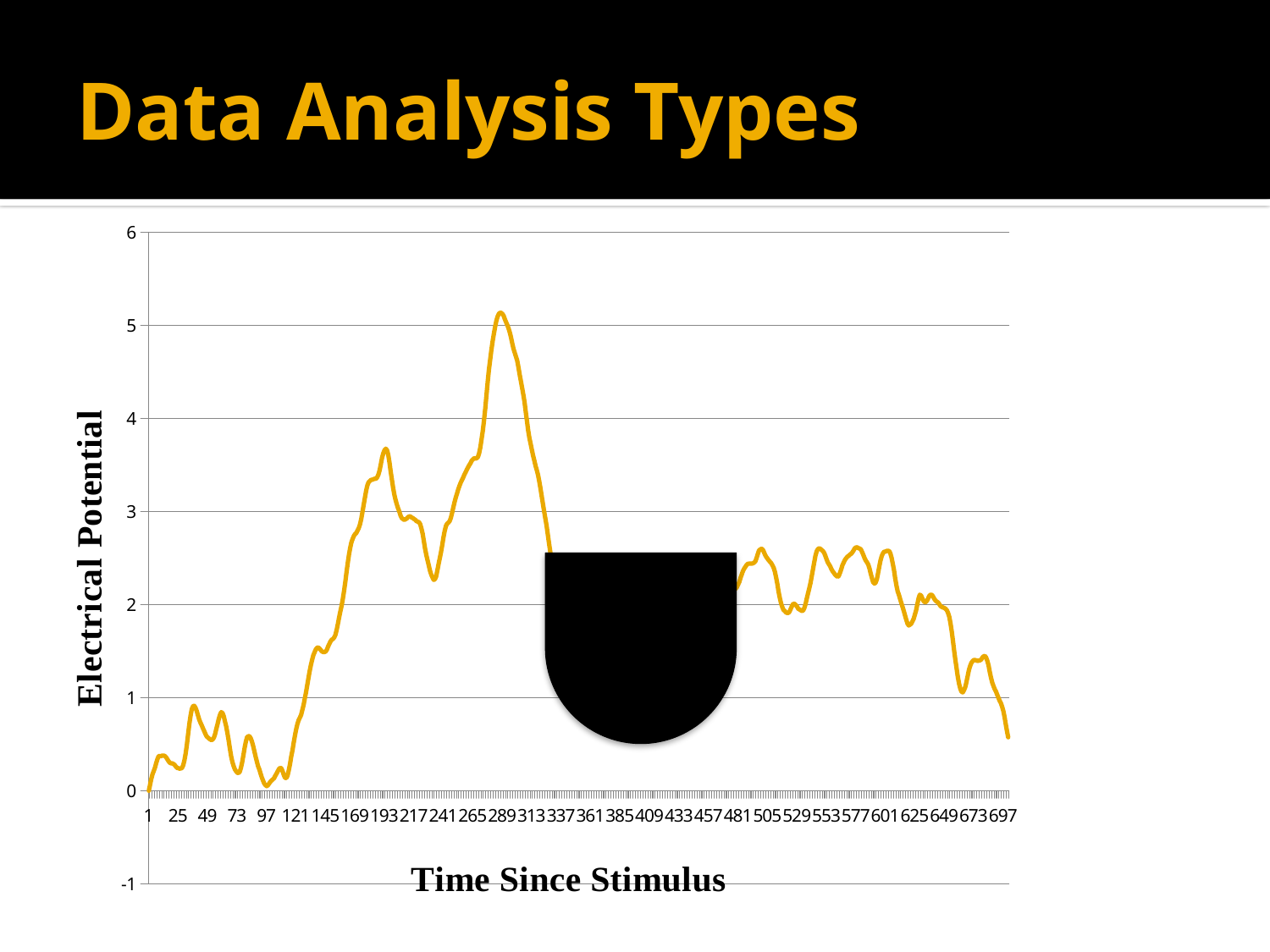
Is the value of the line at time 193 greater or less than 3? greater How many lines (data series) are plotted on the chart? 1 Is the value of the line at time 1 greater or less than 1? less What is the highest value shown on the vertical axis of the chart? 6 Is the value of the line at time 121 greater or less than 2? less What is the title of the vertical axis of the chart? Electrical Potential What kind of chart is shown on the slide? line chart Does the line rise or fall between time 121 and time 289? rise Does the line rise or fall between time 601 and time 697? fall What is the title of the horizontal axis of the chart? Time Since Stimulus